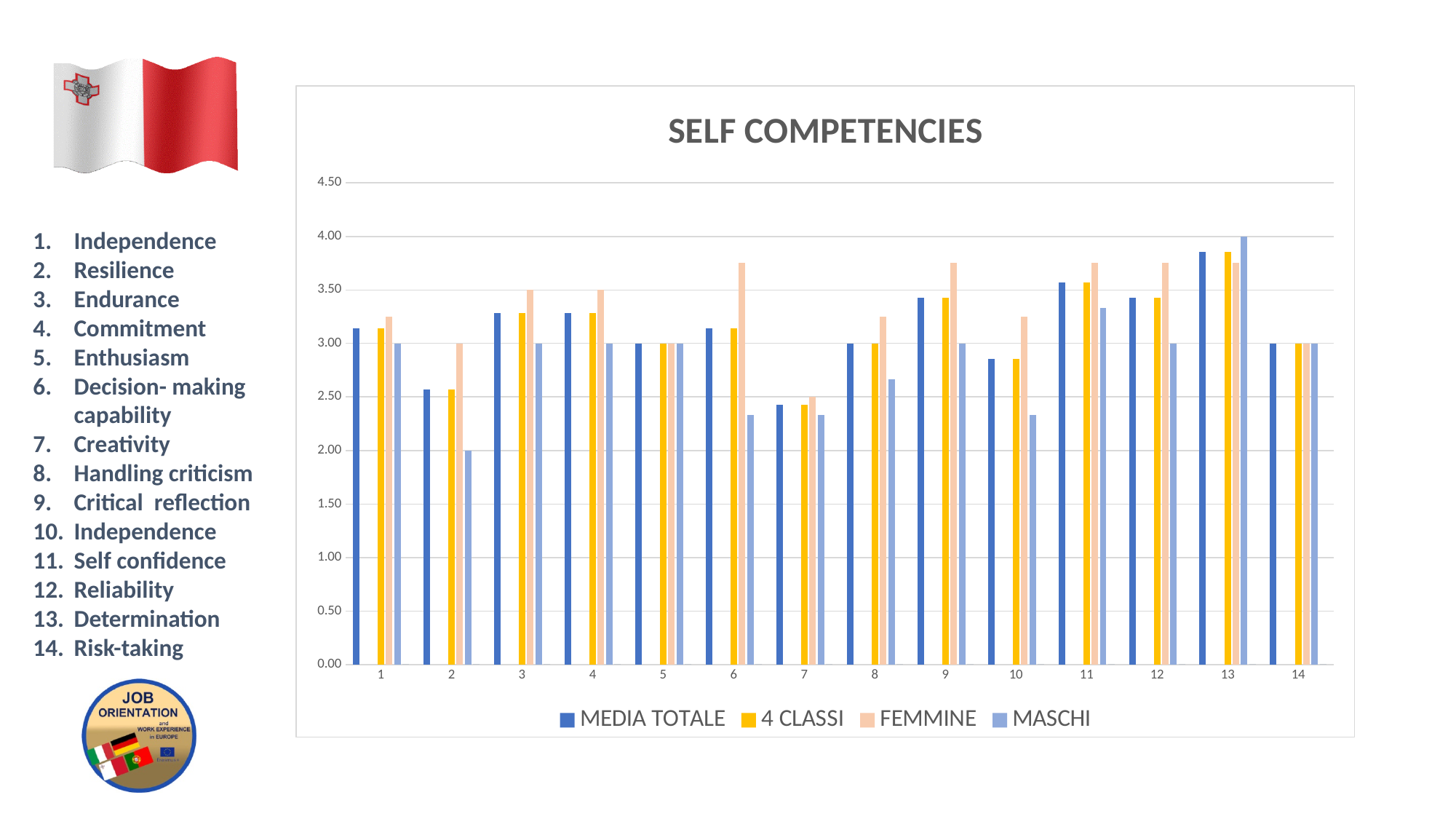
What type of chart is shown on the slide? bar chart What is the FEMMINE value for category 5? 3.00 How many categories are shown on the x axis? 14 For category 2, which is larger: FEMMINE or MASCHI? FEMMINE Is the FEMMINE value for category 6 greater or less than 3.50? greater For which category is the MASCHI series highest? 13 What is the MASCHI value for category 2? 2.00 For which category is the MASCHI series lowest? 2 What is the MASCHI value for category 13? 4.00 What is the difference between the FEMMINE and MASCHI values for category 2? 1.00 How many series does the legend list? 4 What is the title of the chart? SELF COMPETENCIES